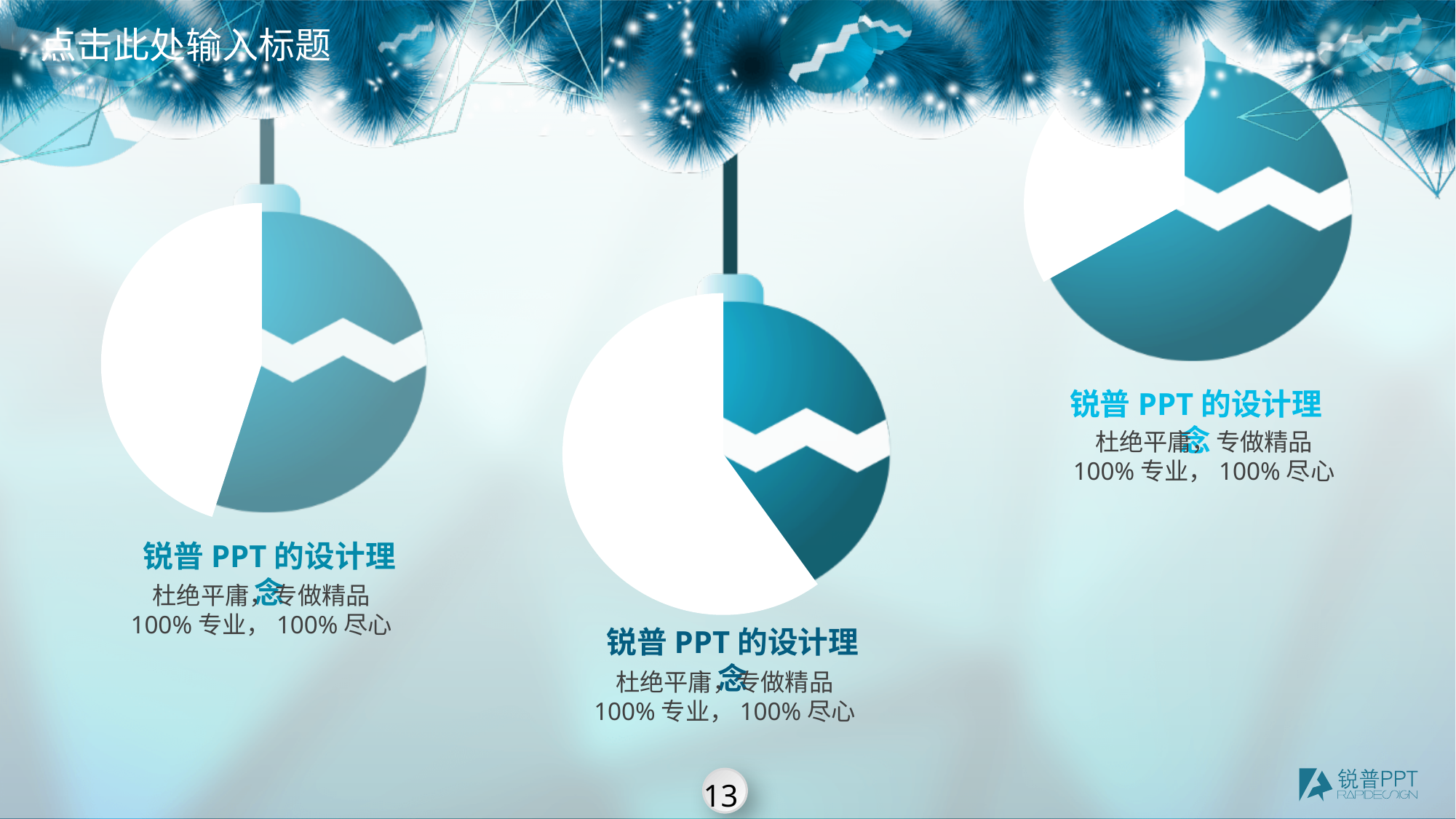
How many slices does the left pie chart have? 2 What kind of chart is the left chart on the slide? pie chart How many slices does the right pie chart have? 2 What kind of chart is the right chart on the slide? pie chart What is the heading text shown below the left pie chart? 锐普 PPT 的设计理 In the left pie chart, which slice is larger, the white slice or the blue slice? the blue slice What kind of chart is the middle chart on the slide? pie chart How many pie charts are shown on the slide? 3 How many slices does the middle pie chart have? 2 In the middle pie chart, which slice is larger, the white slice or the blue slice? the white slice In the right pie chart, which slice is larger, the white slice or the blue slice? the blue slice